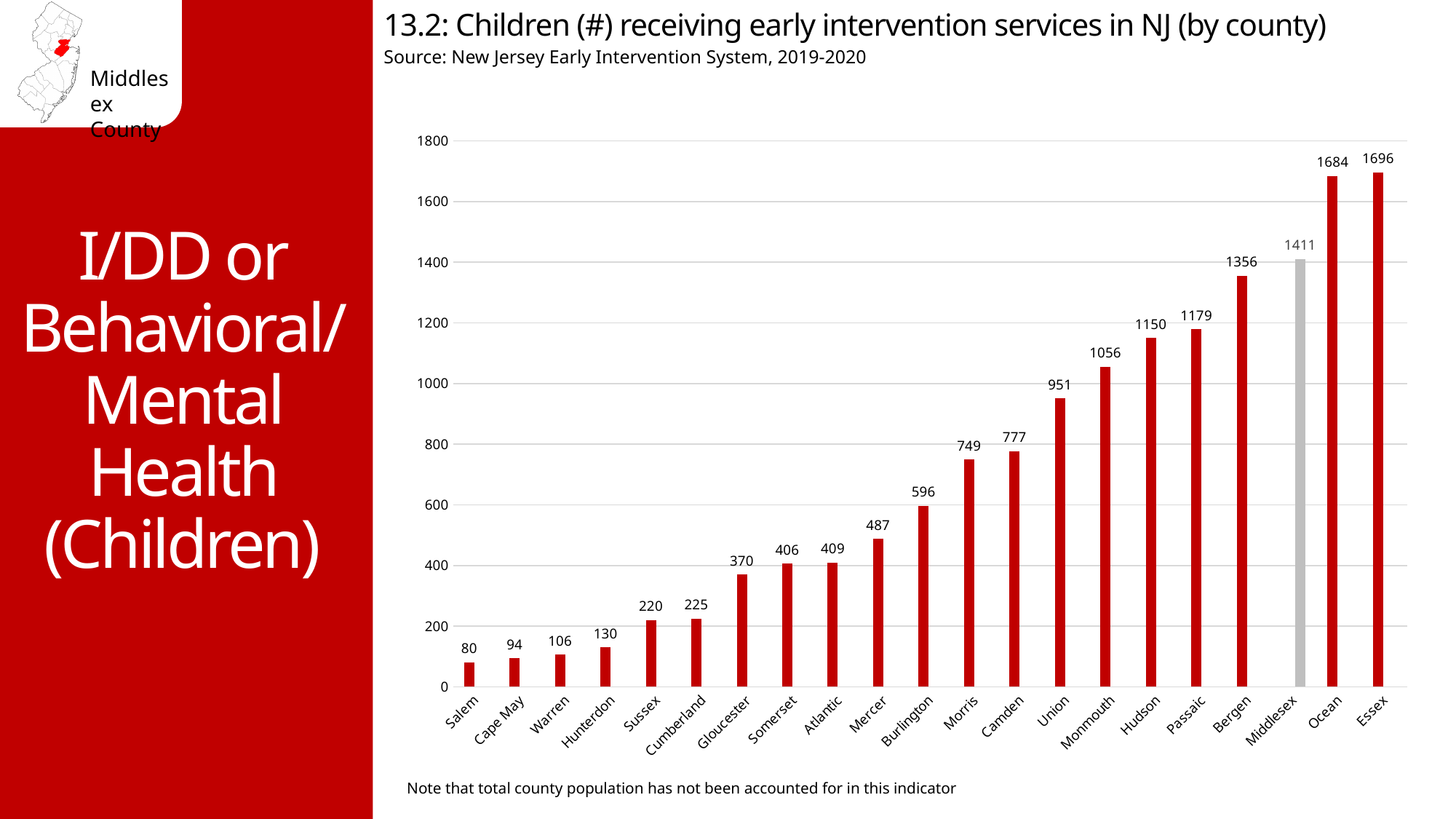
Which county has the highest number of children receiving early intervention services? Essex Which county has a larger value, Hudson or Passaic? Passaic What is the value shown for Bergen County? 1356 Which county's bar is shown in grey rather than red? Middlesex How many counties are shown on the x axis of the chart? 21 What kind of chart is shown on the slide? Bar chart How many children received early intervention services in Middlesex County? 1411 What is the value shown for Salem County? 80 What is the difference between the values for Essex and Ocean counties? 12 Do the values rise or fall moving from left to right along the x axis? Rise Which county has the lowest number of children receiving early intervention services? Salem What is the difference between the values for Middlesex and Bergen counties? 55